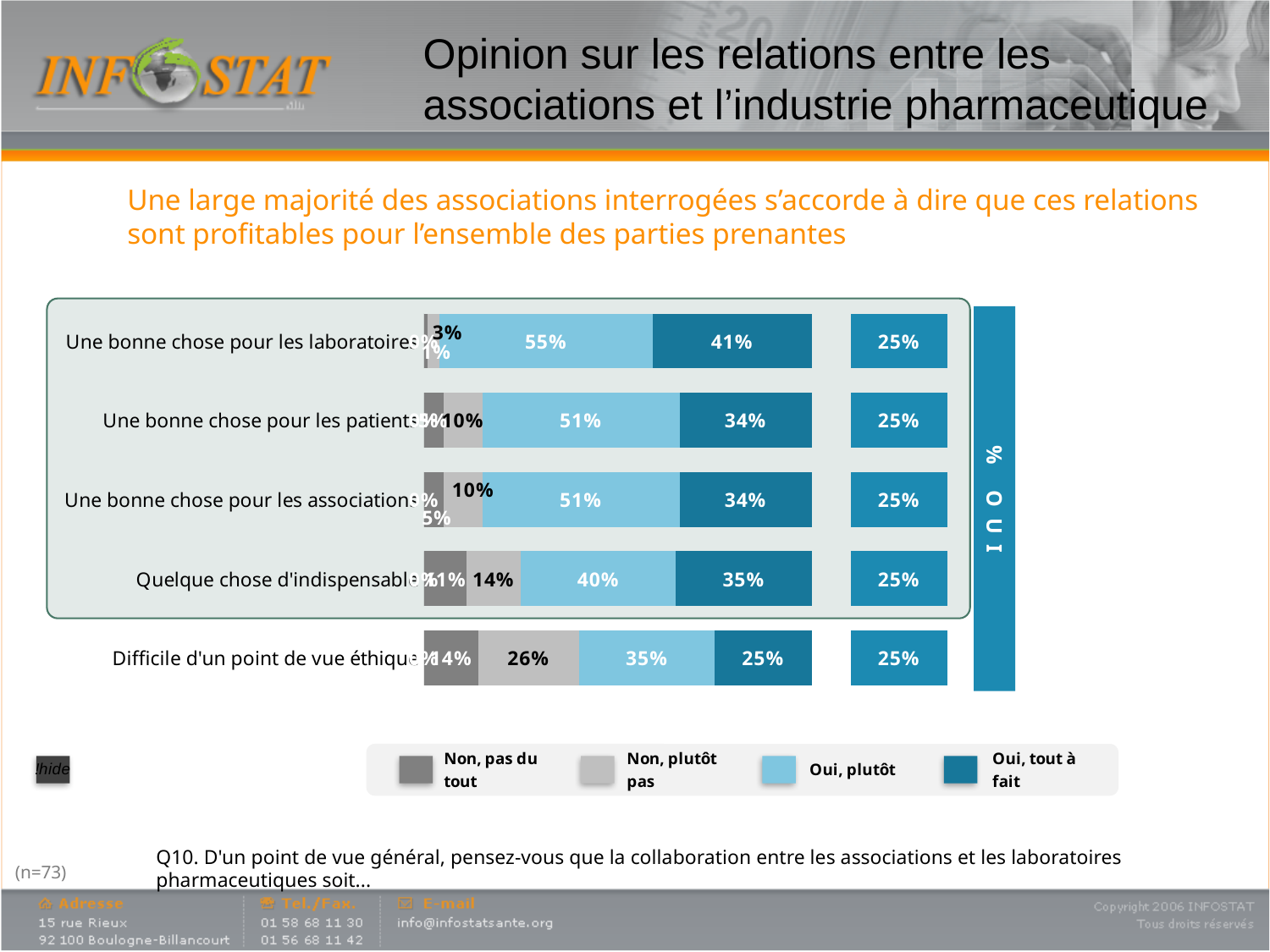
What is the 'Oui, tout à fait' value for 'Une bonne chose pour les patients'? 34% What is the difference between the 'Oui, plutôt' values for 'Une bonne chose pour les laboratoires' and 'Difficile d'un point de vue éthique'? 20% How many statements (categories) are plotted in the chart? 5 Which statement has the lowest 'Oui, tout à fait' value? Difficile d'un point de vue éthique What kind of chart is shown on the slide? stacked bar chart How many series does the legend list? 4 What is the 'Oui, plutôt' value for 'Une bonne chose pour les laboratoires'? 55% What is the 'Non, plutôt pas' value for 'Difficile d'un point de vue éthique'? 26% What is the 'Oui, plutôt' value for 'Quelque chose d'indispensable'? 40% What is the 'Oui, tout à fait' value for 'Une bonne chose pour les laboratoires'? 41% Which is larger: the 'Oui, tout à fait' value for 'Quelque chose d'indispensable' or for 'Une bonne chose pour les associations'? Quelque chose d'indispensable Which statement has the highest 'Oui, tout à fait' value? Une bonne chose pour les laboratoires